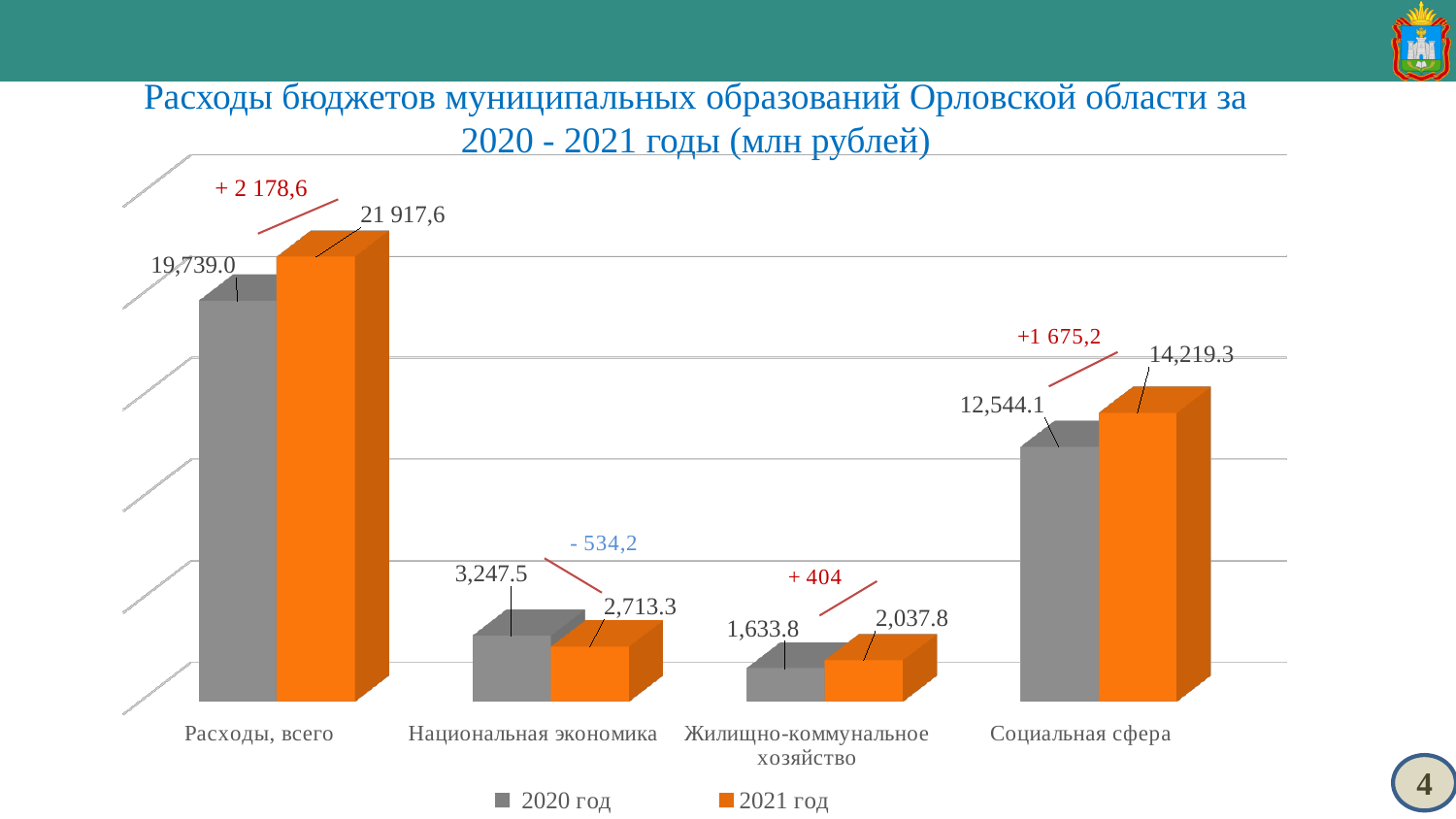
What is the value for Жилищно-коммунальное хозяйство in 2020 год? 1,633.8 What is the difference between the 2021 год and 2020 год values for Социальная сфера? 1,675.2 What kind of chart is shown on the slide? bar chart Which category has the highest value in 2021 год? Расходы, всего How many series does the legend list? 2 Is the value for Национальная экономика larger in 2020 год or in 2021 год? 2020 год What is the value for Социальная сфера in 2021 год? 14,219.3 Which category has the lowest value in 2020 год? Жилищно-коммунальное хозяйство What is the value for Расходы, всего in 2020 год? 19,739.0 What is the value for Национальная экономика in 2021 год? 2,713.3 What is the value for Расходы, всего in 2021 год? 21 917,6 How many categories are shown on the x axis? 4